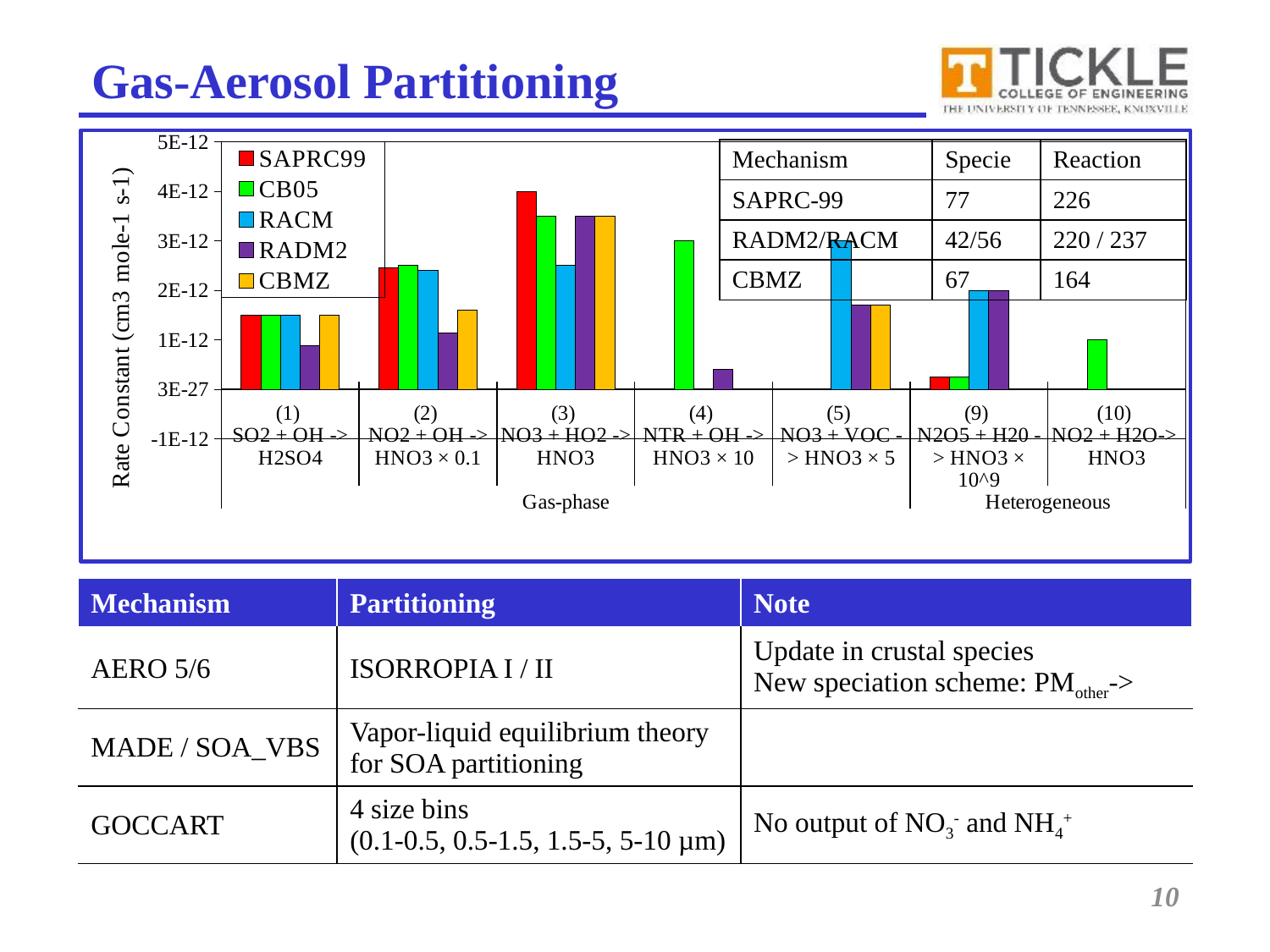
For reaction (2) NO2 + OH -> HNO3 × 0.1, which is larger, the SAPRC99 value or the RADM2 value? SAPRC99 Is the SAPRC99 value for reaction (3) NO3 + HO2 -> HNO3 greater or less than 3E-12? greater Which series has the highest bar for reaction (3) NO3 + HO2 -> HNO3? SAPRC99 Which series is shown in red in the chart legend? SAPRC99 Which series has the lowest bar for reaction (2) NO2 + OH -> HNO3 × 0.1? RADM2 How many reaction categories are shown along the x axis of the chart? 7 What kind of chart is shown on the slide? Bar chart Is the RADM2 value for reaction (4) NTR + OH -> HNO3 × 10 greater or less than 1E-12? less Which series has the highest bar for reaction (4) NTR + OH -> HNO3 × 10? CB05 How many series does the chart legend list? 5 What is the title of the chart's y axis? Rate Constant (cm3 mole-1 s-1) Which reaction category contains the tallest bar in the chart? (3) NO3 + HO2 -> HNO3